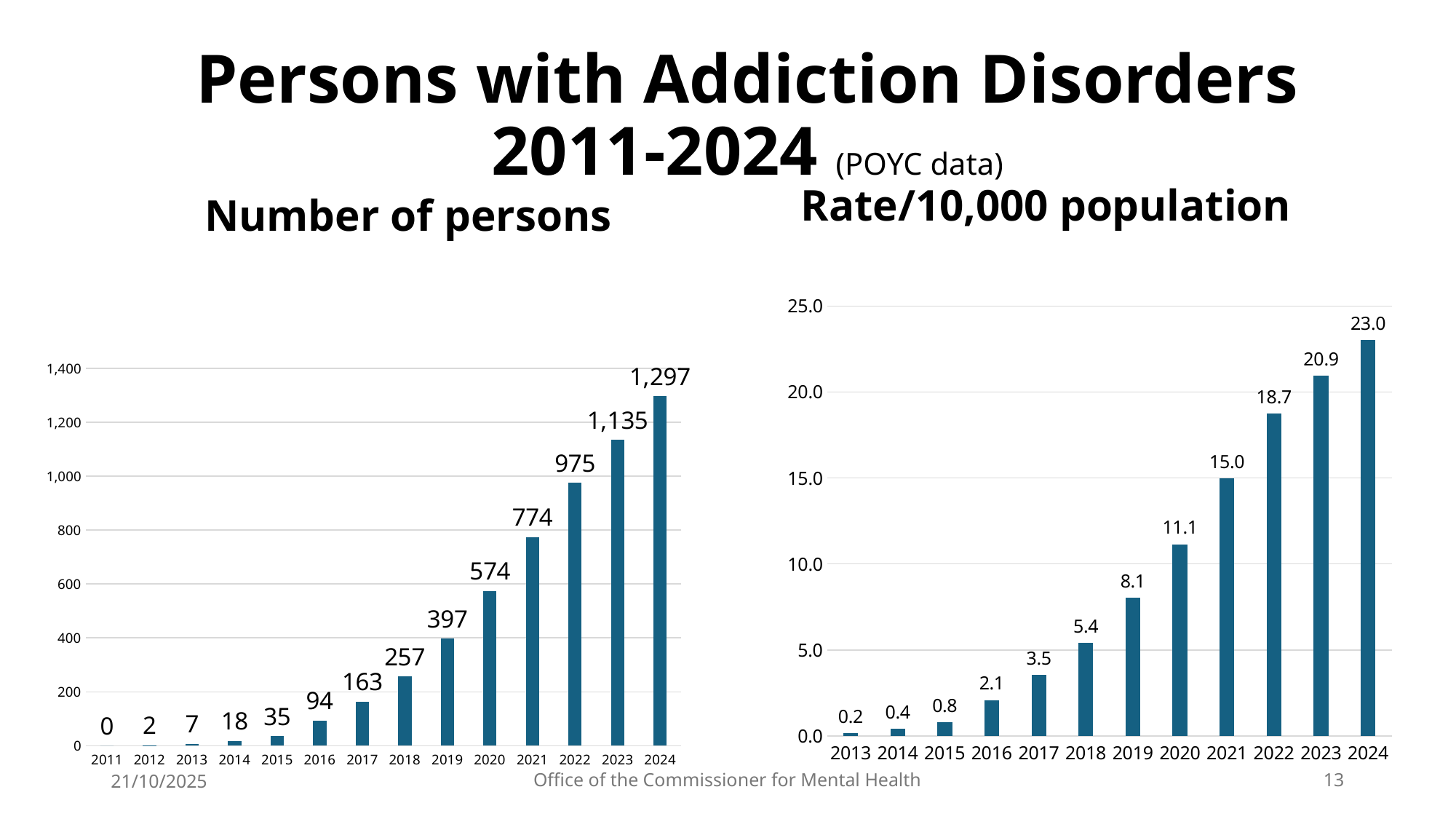
In the 'Number of persons' chart, which year has the highest value? 2024 In the 'Rate/10,000 population' chart, do the values rise or fall from 2013 to 2024? Rise In the 'Rate/10,000 population' chart, which year has the lowest value? 2013 In the 'Number of persons' chart, what is the value for 2024? 1,297 In the 'Number of persons' chart, what is the value for 2020? 574 In the 'Rate/10,000 population' chart, what is the value for 2022? 18.7 In the 'Number of persons' chart, which is larger: the value for 2018 or the value for 2019? 2019 How many years are shown on the x axis of the 'Rate/10,000 population' chart? 12 In the 'Rate/10,000 population' chart, what is the value for 2019? 8.1 What kind of chart is the 'Number of persons' chart? Bar chart In the 'Number of persons' chart, what is the difference between the values for 2023 and 2022? 160 In the 'Rate/10,000 population' chart, what is the difference between the values for 2024 and 2023? 2.1